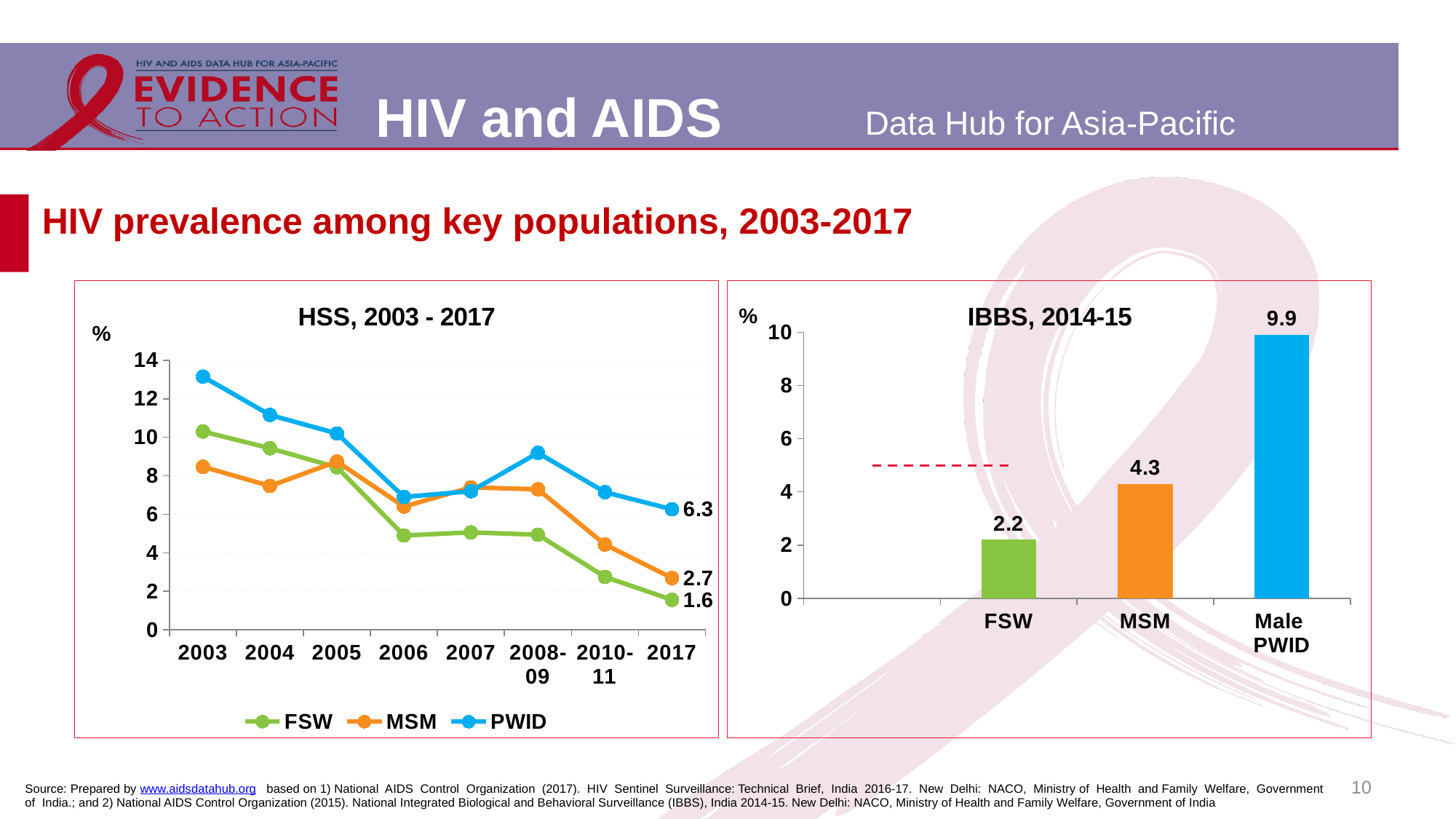
In the 'IBBS, 2014-15' chart, what is the difference between the Male PWID and FSW values? 7.7 In the 'HSS, 2003 - 2017' chart, does the PWID series generally rise or fall from 2003 to 2017? fall In the 'HSS, 2003 - 2017' chart, what is the value for FSW in 2017? 1.6 In the 'HSS, 2003 - 2017' chart, how many series does the legend list? 3 In the 'HSS, 2003 - 2017' chart, what is the difference between the MSM and FSW values in 2017? 1.1 In the 'IBBS, 2014-15' chart, how many categories are shown? 3 In the 'IBBS, 2014-15' chart, what is the value for MSM? 4.3 What kind of chart is the 'IBBS, 2014-15' chart? bar chart In the 'IBBS, 2014-15' chart, which category has the highest value? Male PWID In the 'HSS, 2003 - 2017' chart, which series has the highest value in 2003? PWID In the 'HSS, 2003 - 2017' chart, what is the value for PWID in 2017? 6.3 In the 'HSS, 2003 - 2017' chart, is the value for PWID in 2003 greater or less than 12? greater